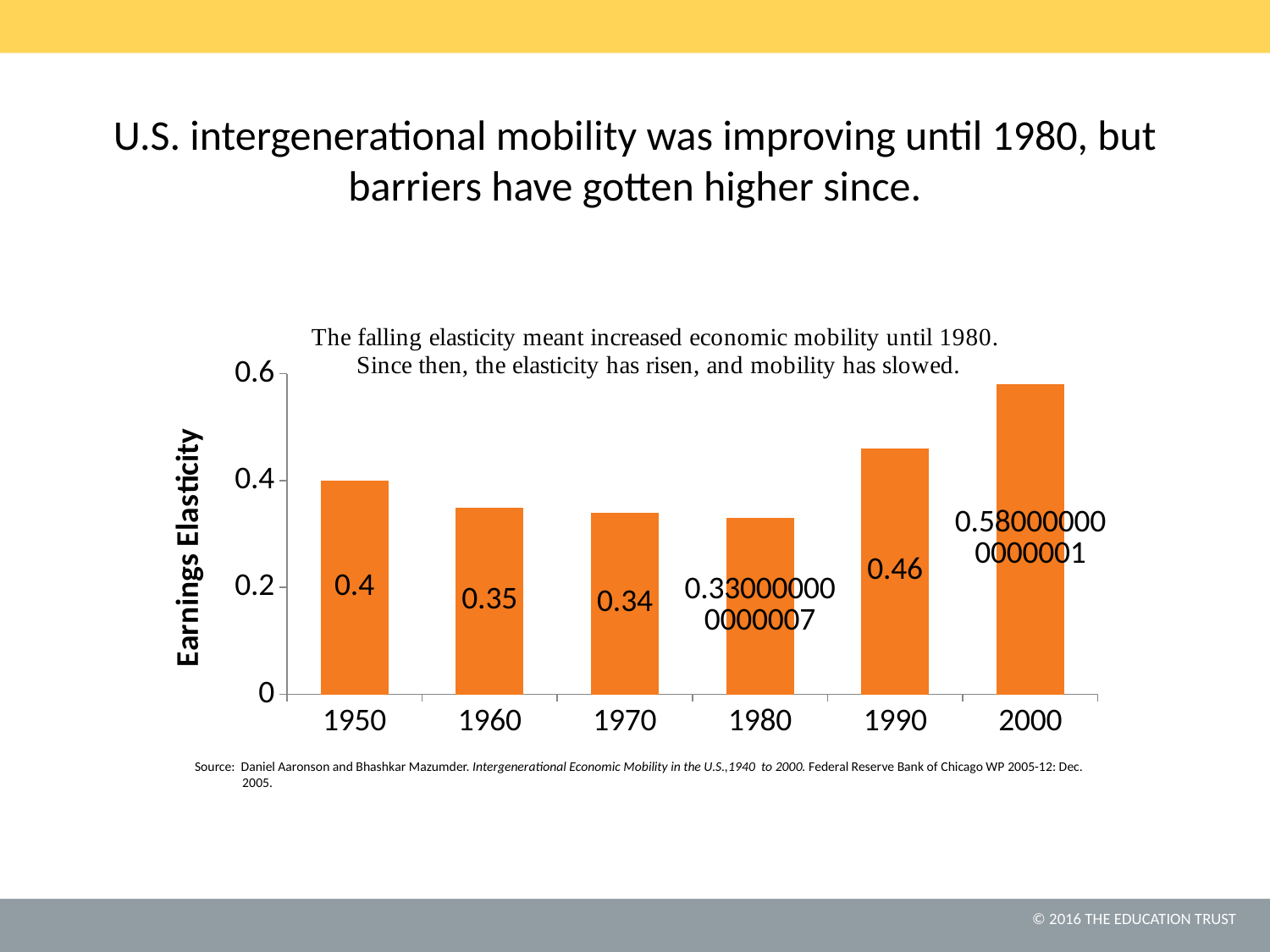
How many years are shown on the x axis of the chart? 6 What kind of chart is shown on the slide? bar chart What is the difference between the earnings elasticity in 1950 and in 1960? 0.05 Which year has the highest earnings elasticity? 2000 Which year has the lowest earnings elasticity? 1980 What is the earnings elasticity value for 1950? 0.4 Which year has a larger earnings elasticity, 1960 or 1990? 1990 What is the earnings elasticity value for 1970? 0.34 Is the value for 2000 greater or less than 0.4? greater What is the earnings elasticity value for 1960? 0.35 Do the earnings elasticity values rise or fall from 1950 to 1980? fall What is the earnings elasticity value for 1990? 0.46